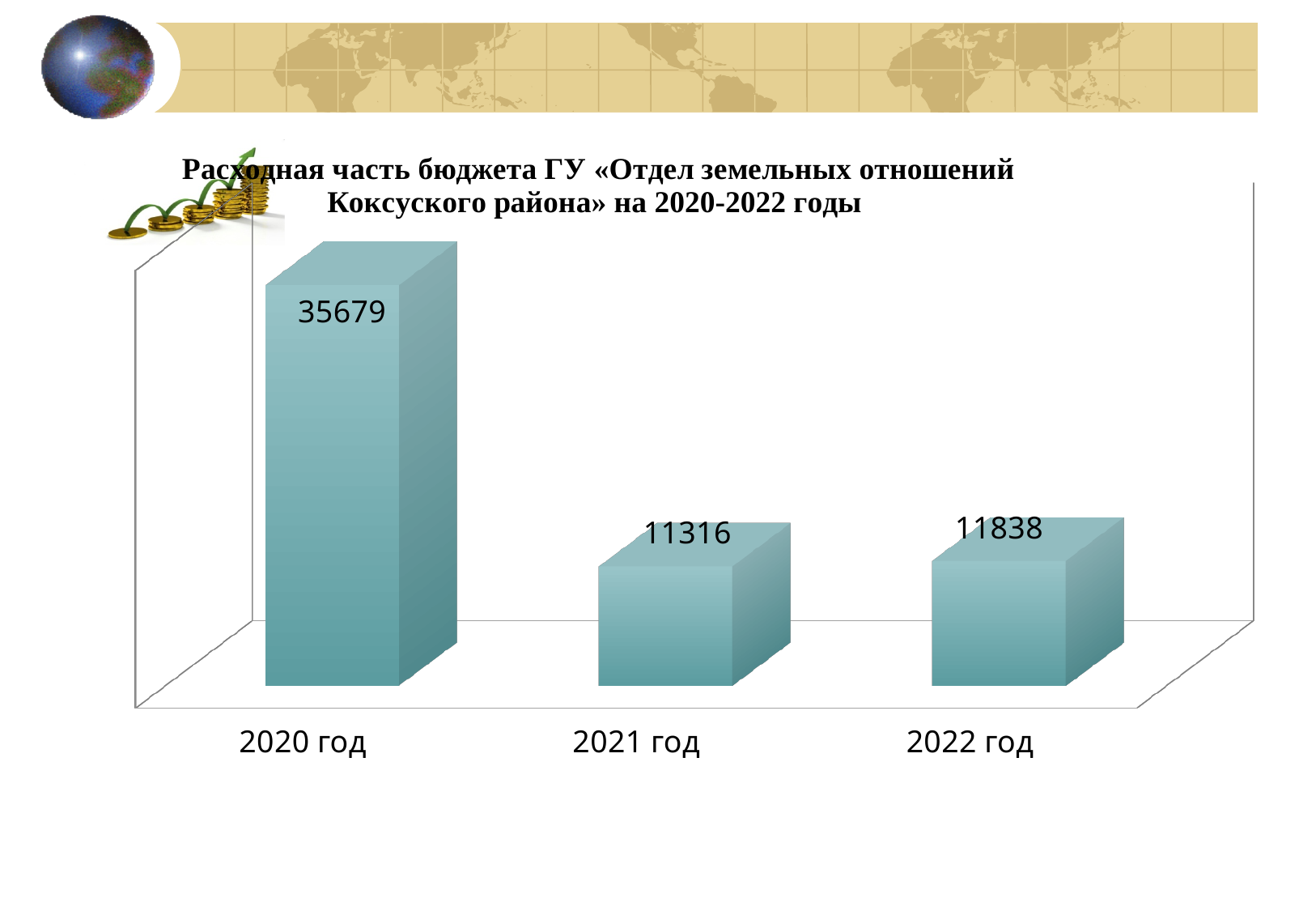
What is the value for 2021 год? 11316 What is the difference between the values for 2020 год and 2021 год? 24363 What is the difference between the values for 2022 год and 2021 год? 522 What kind of chart is shown on the slide? bar chart What is the value for 2022 год? 11838 Does the value rise or fall from 2020 год to 2021 год? fall Which is larger, the value for 2020 год or the value for 2022 год? 2020 год What is the value for 2020 год? 35679 How many years are shown on the chart? 3 Which year has the lowest value? 2021 год Which year has the highest value? 2020 год What is the title of the chart? Расходная часть бюджета ГУ «Отдел земельных отношений Коксуского района» на 2020-2022 годы